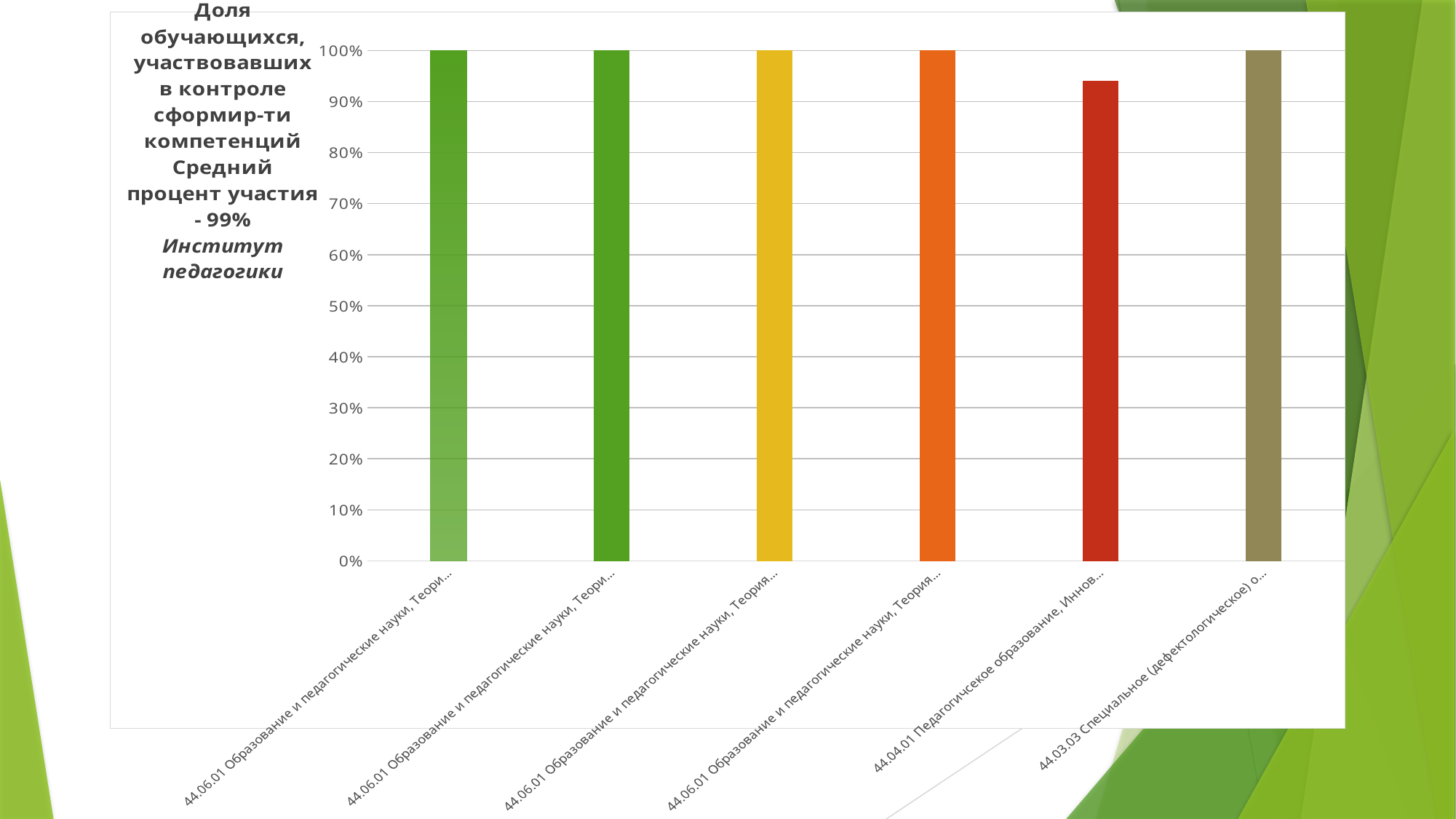
Which category has the lowest bar in the chart? 44.04.01 Педагогическое образование How many bars does the chart contain? 6 What is the value of the leftmost bar in the chart? 100% Which is larger: the value for 44.03.03 Специальное (дефектологическое) or the value for 44.04.01 Педагогическое образование? 44.03.03 Специальное (дефектологическое) According to the chart title, what is the average participation percentage (средний процент участия)? 99% What is the value for 44.03.03 Специальное (дефектологическое)? 100% How many bars in the chart reach 100%? 5 Which institute is named in the chart title? Институт педагогики Is the value for 44.04.01 Педагогическое образование greater or less than 100%? less Is the value for 44.04.01 Педагогическое образование greater or less than 90%? greater What kind of chart is shown on the slide? bar chart